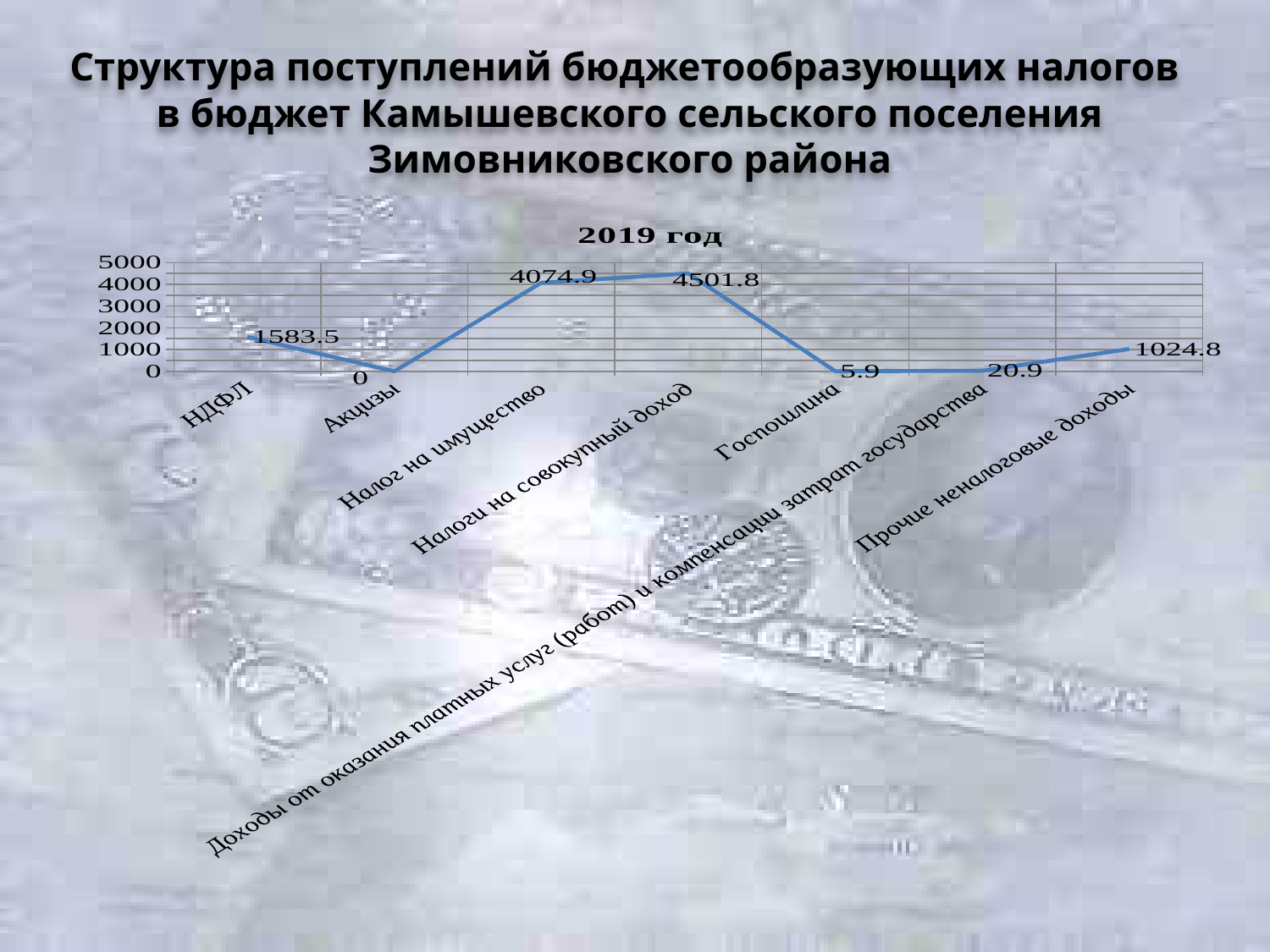
What kind of chart is shown on the slide? line chart How many categories are plotted on the x axis? 7 What is the title of the chart? 2019 год Which category has the lowest value? Акцизы What is the difference between the values for Налоги на совокупный доход and Налог на имущество? 426.9 Which is larger, the value for НДФЛ or the value for Прочие неналоговые доходы? НДФЛ What is the value for Госпошлина? 5.9 What is the value for Прочие неналоговые доходы? 1024.8 Which category has the highest value? Налоги на совокупный доход Is the value for Налог на имущество greater or less than 3000? greater What is the value for Налог на имущество? 4074.9 What is the value for НДФЛ in the chart? 1583.5